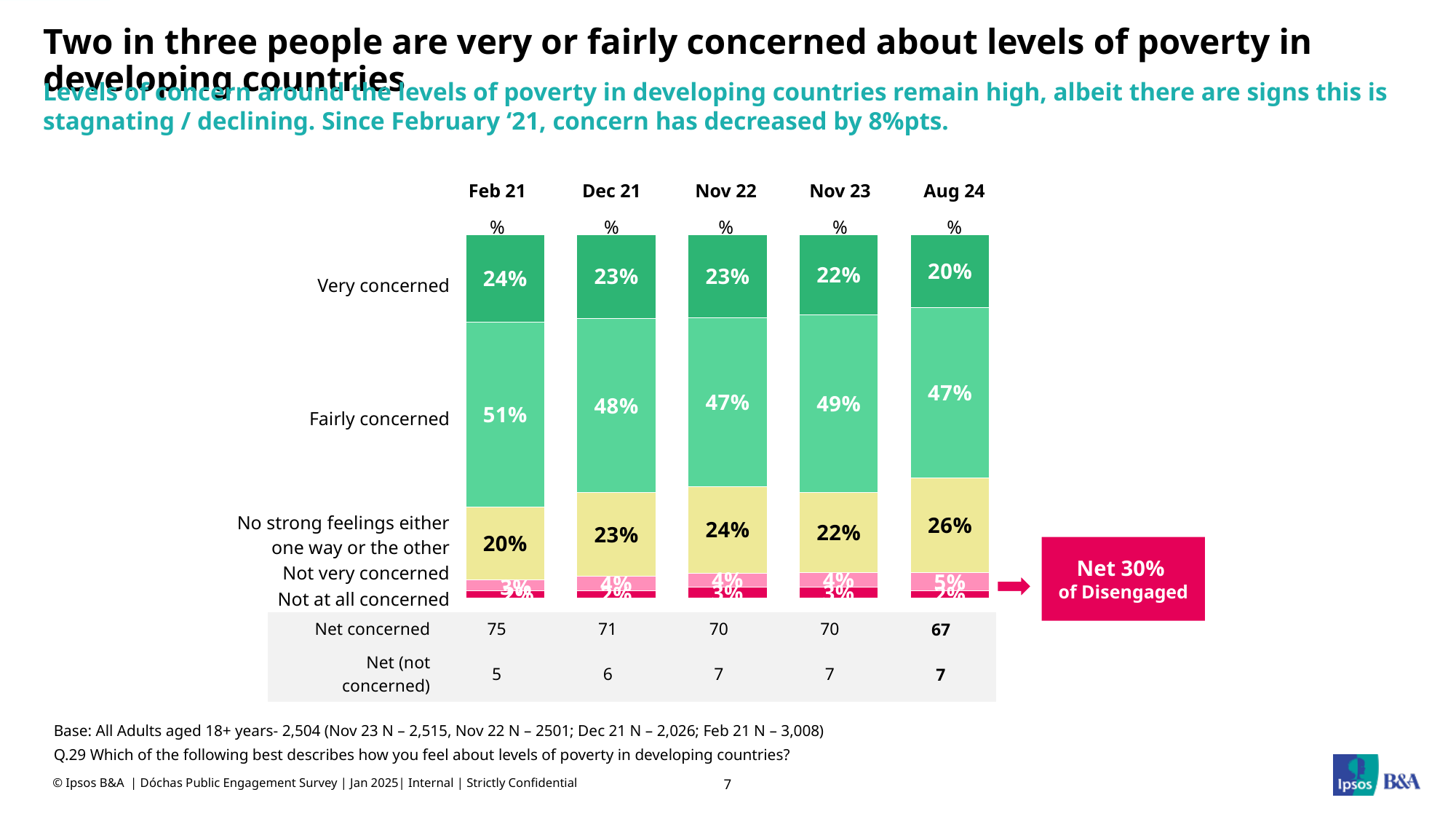
Which is larger: 'Fairly concerned' in Nov 23 or 'Fairly concerned' in Nov 22? Nov 23 In which wave was the 'Very concerned' share highest? Feb 21 Does the 'Very concerned' share rise or fall across the waves from Feb 21 to Aug 24? Fall By how many percentage points did 'Fairly concerned' change from Feb 21 to Aug 24? 4 percentage points What is the 'Net concerned' figure for Aug 24? 67 What percentage had 'No strong feelings either one way or the other' in Nov 22? 24% How many survey waves are shown in the chart? 5 What is the difference between the 'Net concerned' figures for Feb 21 and Aug 24? 8 What percentage of people were 'Very concerned' in Aug 24? 20% What type of chart is shown on the slide? Stacked bar chart In which wave was the 'No strong feelings either one way or the other' share lowest? Feb 21 What percentage of people were 'Fairly concerned' in Feb 21? 51%